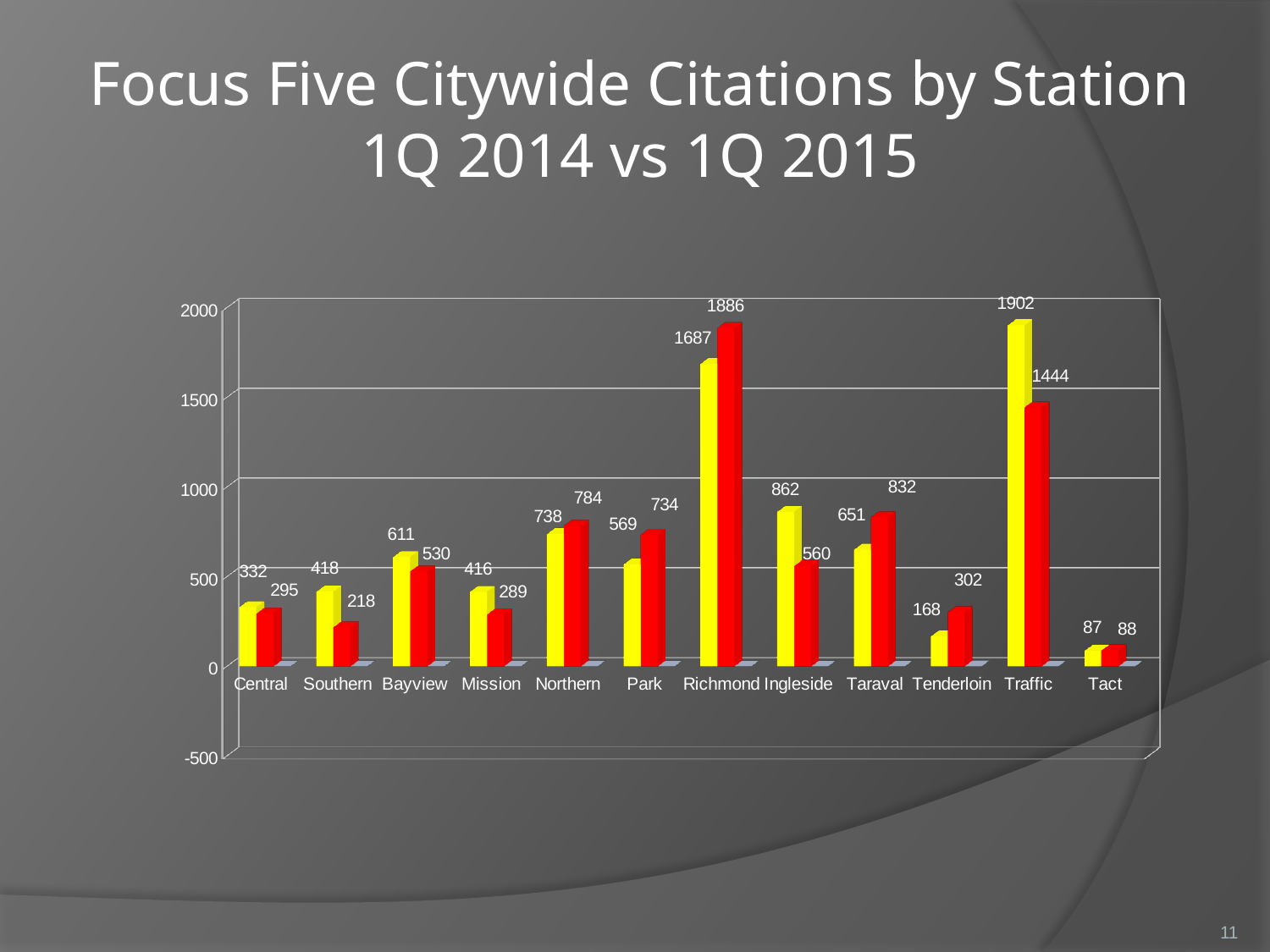
Which station has the highest red bar? Richmond Which station has the highest yellow bar? Traffic For Taraval, which is larger, the yellow bar or the red bar? the red bar What kind of chart is shown on the slide? bar chart What is the value of the red bar for Ingleside? 560 Which station has the lowest yellow bar? Tact Is the yellow bar for Bayview greater or less than 500? greater What is the difference between the yellow and red bars for Traffic? 458 How many stations are shown on the x axis? 12 What is the value of the red bar for Tenderloin? 302 What is the difference between the red bars for Northern and Park? 50 What is the value of the yellow bar for Richmond? 1687